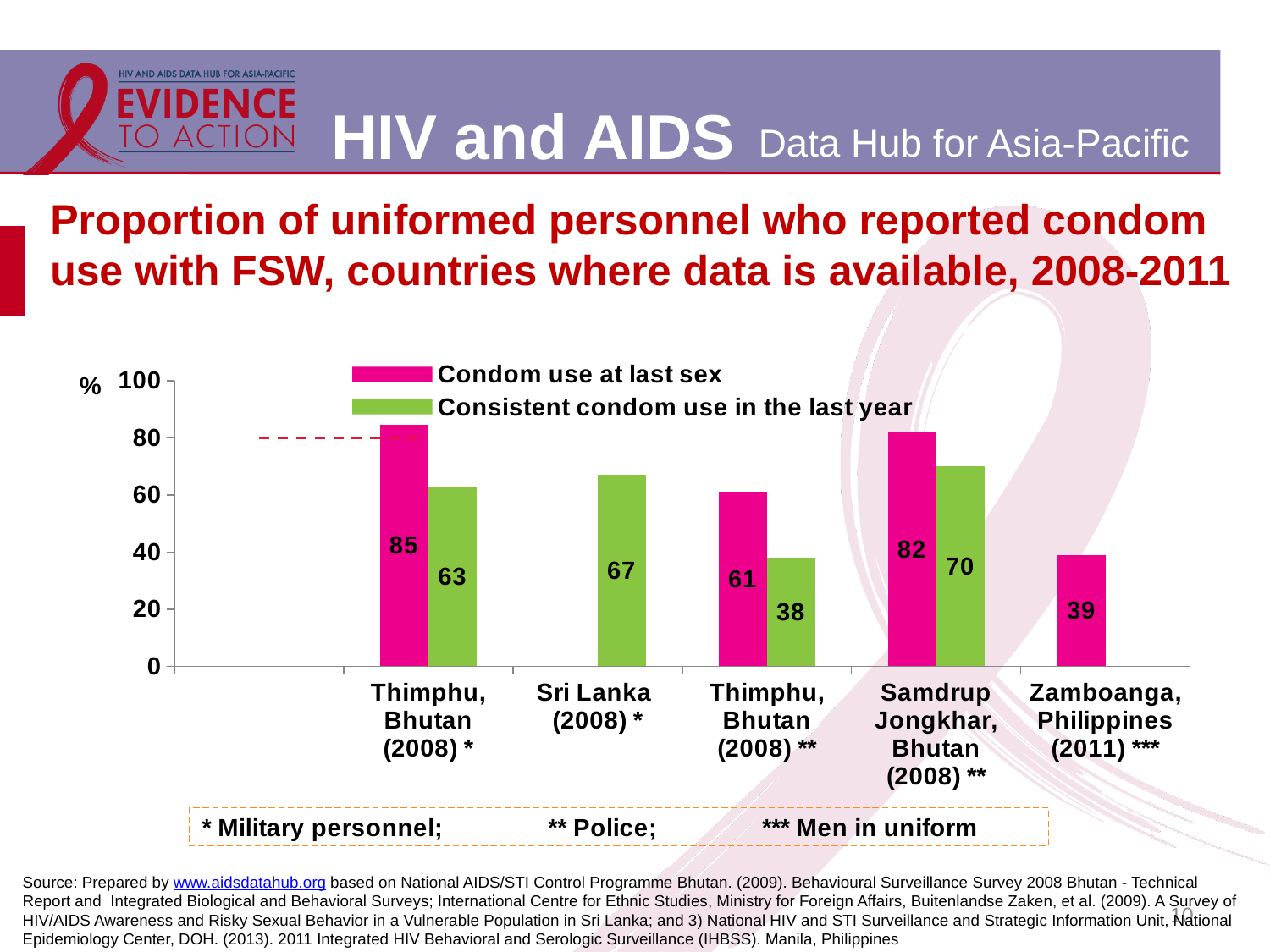
What is the value for consistent condom use in the last year for Sri Lanka (2008) *? 67 Which category has the highest value for condom use at last sex? Thimphu, Bhutan (2008) * What is the difference between condom use at last sex and consistent condom use in the last year for Samdrup Jongkhar, Bhutan (2008) **? 12 What is the value for condom use at last sex among military personnel in Thimphu, Bhutan (2008) *? 85 Is the value for condom use at last sex in Samdrup Jongkhar, Bhutan (2008) ** greater or less than 80? greater Which is larger: consistent condom use in the last year in Samdrup Jongkhar, Bhutan (2008) ** or in Thimphu, Bhutan (2008) *? Samdrup Jongkhar, Bhutan (2008) ** What is the value for condom use at last sex in Zamboanga, Philippines (2011) ***? 39 What is the value for consistent condom use in the last year among police in Thimphu, Bhutan (2008) **? 38 Which category has the lowest value for consistent condom use in the last year? Thimphu, Bhutan (2008) ** How many series does the legend list? 2 How many categories are shown on the x axis? 5 What kind of chart is shown on the slide? Bar chart